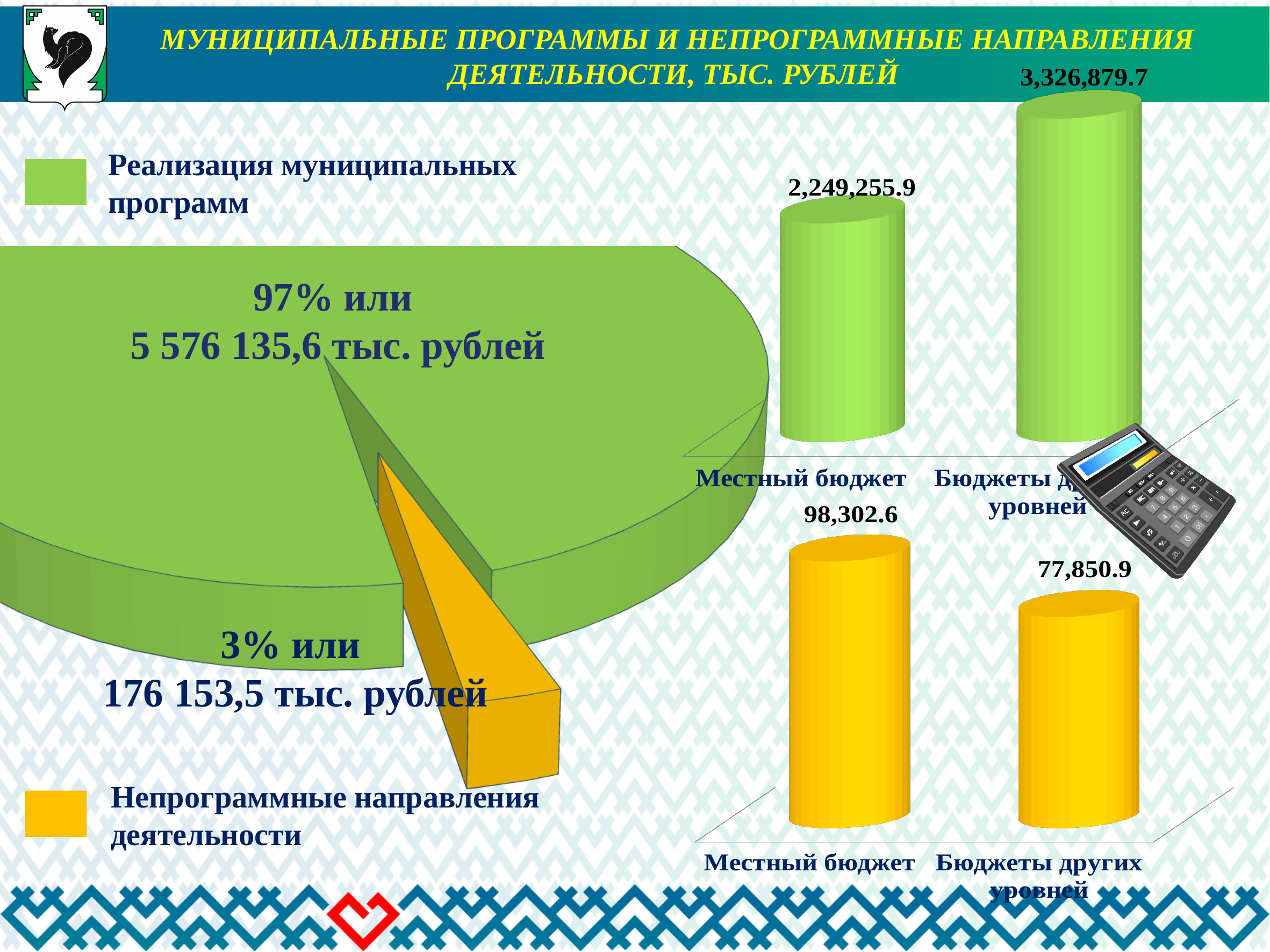
In the lower yellow bar chart on the right, what is the difference between Местный бюджет and Бюджеты других уровней? 20,451.7 What type of chart is shown on the left side of the slide? Pie chart In the pie chart on the left, what value in тыс. рублей is shown for Непрограммные направления деятельности? 176 153,5 тыс. рублей In the upper green bar chart on the right, what is the value for Бюджеты других уровней? 3,326,879.7 In the upper green bar chart on the right, what is the value for Местный бюджет? 2,249,255.9 In the lower yellow bar chart on the right, which category has the lowest value? Бюджеты других уровней In the pie chart on the left, what share does the slice for Реализация муниципальных программ have? 97% In the lower yellow bar chart on the right, what is the value for Местный бюджет? 98,302.6 In the upper green bar chart on the right, what is the difference between Бюджеты других уровней and Местный бюджет? 1,077,623.8 In the pie chart on the left, which slice is larger: Реализация муниципальных программ or Непрограммные направления деятельности? Реализация муниципальных программ In the pie chart on the left, what value in тыс. рублей is shown for Реализация муниципальных программ? 5 576 135,6 тыс. рублей In the pie chart on the left, what share does the slice for Непрограммные направления деятельности have? 3%